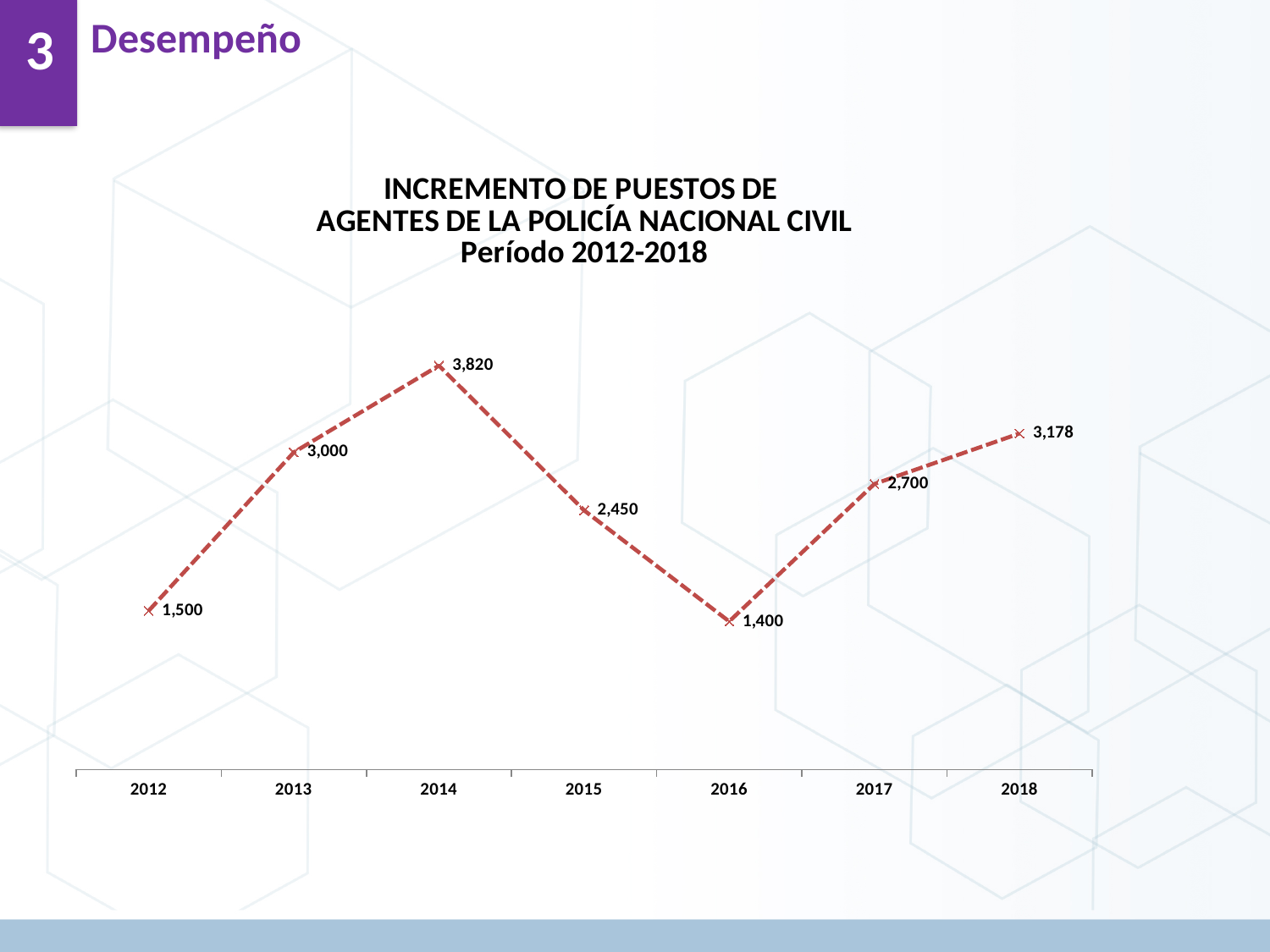
What is the value for 2014? 3,820 Do the values rise or fall from 2016 to 2018? Rise Which is larger, the value for 2013 or the value for 2018? 2018 What is the difference between the values for 2018 and 2017? 478 What is the difference between the values for 2014 and 2015? 1,370 Which year has the lowest value? 2016 What is the value for 2018? 3,178 Which year has the highest value? 2014 How many years are plotted on the x axis? 7 What kind of chart is this? Line chart What period does the chart title say it covers? 2012-2018 What is the value for 2016? 1,400